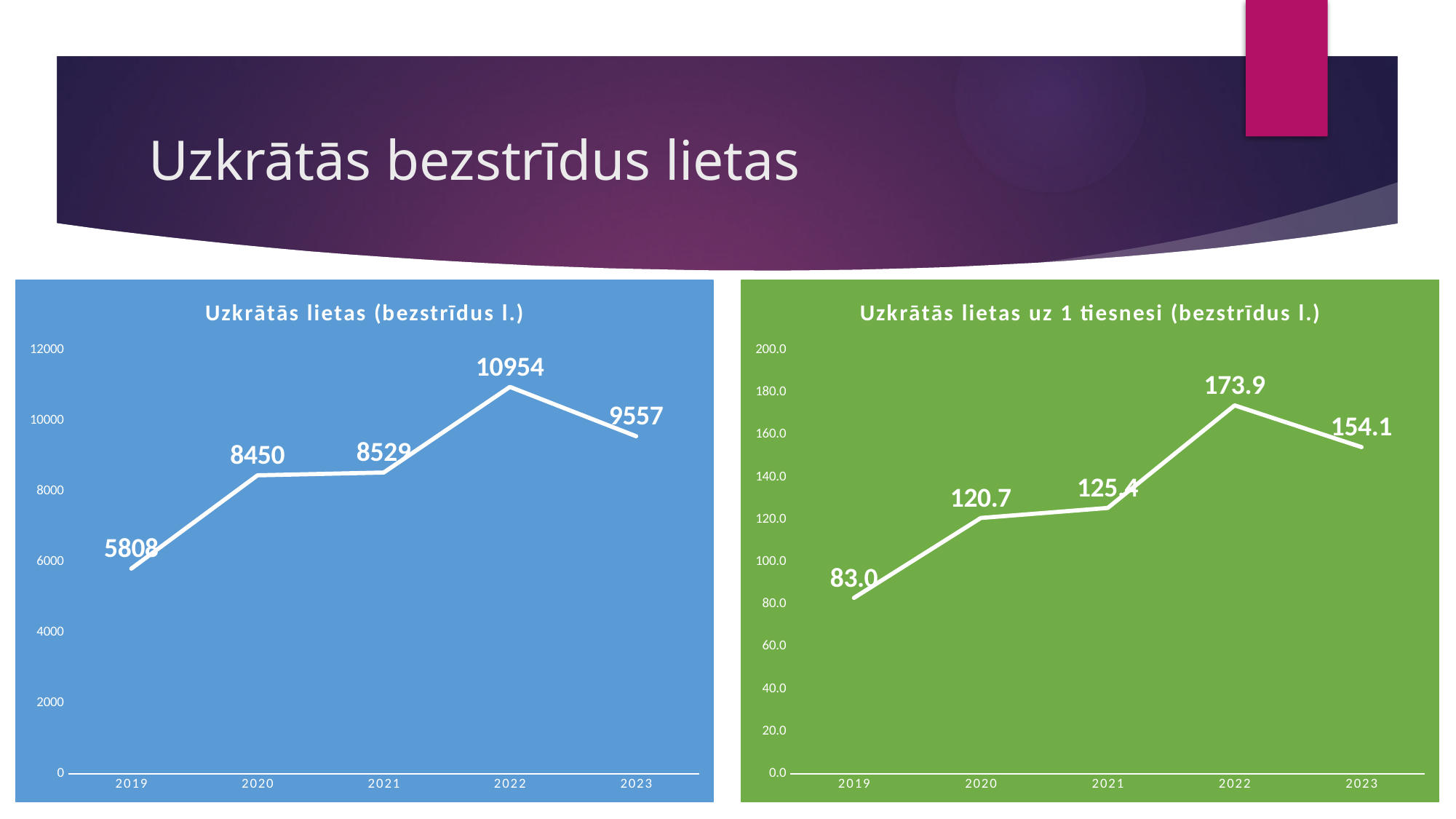
In the chart titled "Uzkrātās lietas (bezstrīdus l.)", which year has the highest value? 2022 In the chart titled "Uzkrātās lietas uz 1 tiesnesi (bezstrīdus l.)", is the value for 2022 larger than the value for 2023? Yes In the chart titled "Uzkrātās lietas uz 1 tiesnesi (bezstrīdus l.)", which year has the highest value? 2022 In the chart titled "Uzkrātās lietas uz 1 tiesnesi (bezstrīdus l.)", do the values rise or fall from 2019 to 2022? rise In the chart titled "Uzkrātās lietas (bezstrīdus l.)", what is the value for 2022? 10954 In the chart titled "Uzkrātās lietas (bezstrīdus l.)", how many years are plotted on the x axis? 5 In the chart titled "Uzkrātās lietas (bezstrīdus l.)", which year has the lowest value? 2019 In the chart titled "Uzkrātās lietas uz 1 tiesnesi (bezstrīdus l.)", what is the value for 2020? 120.7 In the chart titled "Uzkrātās lietas (bezstrīdus l.)", what is the value for 2019? 5808 In the chart titled "Uzkrātās lietas uz 1 tiesnesi (bezstrīdus l.)", what is the value for 2023? 154.1 In the chart titled "Uzkrātās lietas (bezstrīdus l.)", what is the difference between the values for 2022 and 2023? 1397 What kind of chart is the chart titled "Uzkrātās lietas uz 1 tiesnesi (bezstrīdus l.)"? line chart